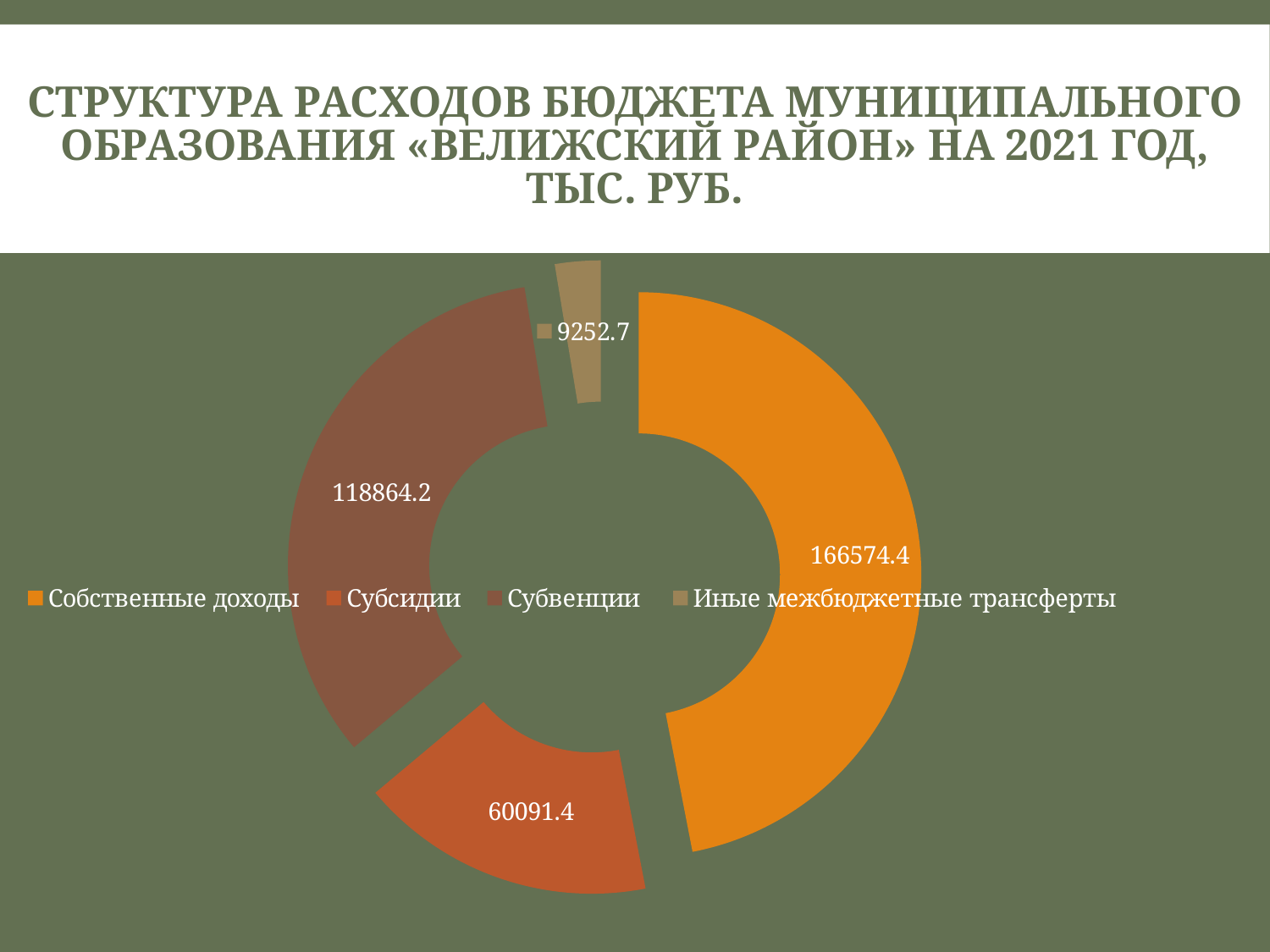
What kind of chart is shown on the slide? doughnut chart How many categories does the chart show? 4 Which is larger, Субсидии or Субвенции? Субвенции What is the value for Субвенции? 118864.2 What is the difference between Субвенции and Субсидии? 58772.8 Which category has the smallest value? Иные межбюджетные трансферты What is the total of all four categories shown in the chart? 354782.7 What is the difference between Собственные доходы and Субвенции? 47710.2 What is the value for Субсидии? 60091.4 What is the value for Иные межбюджетные трансферты? 9252.7 What is the value for Собственные доходы? 166574.4 Which category has the largest value? Собственные доходы